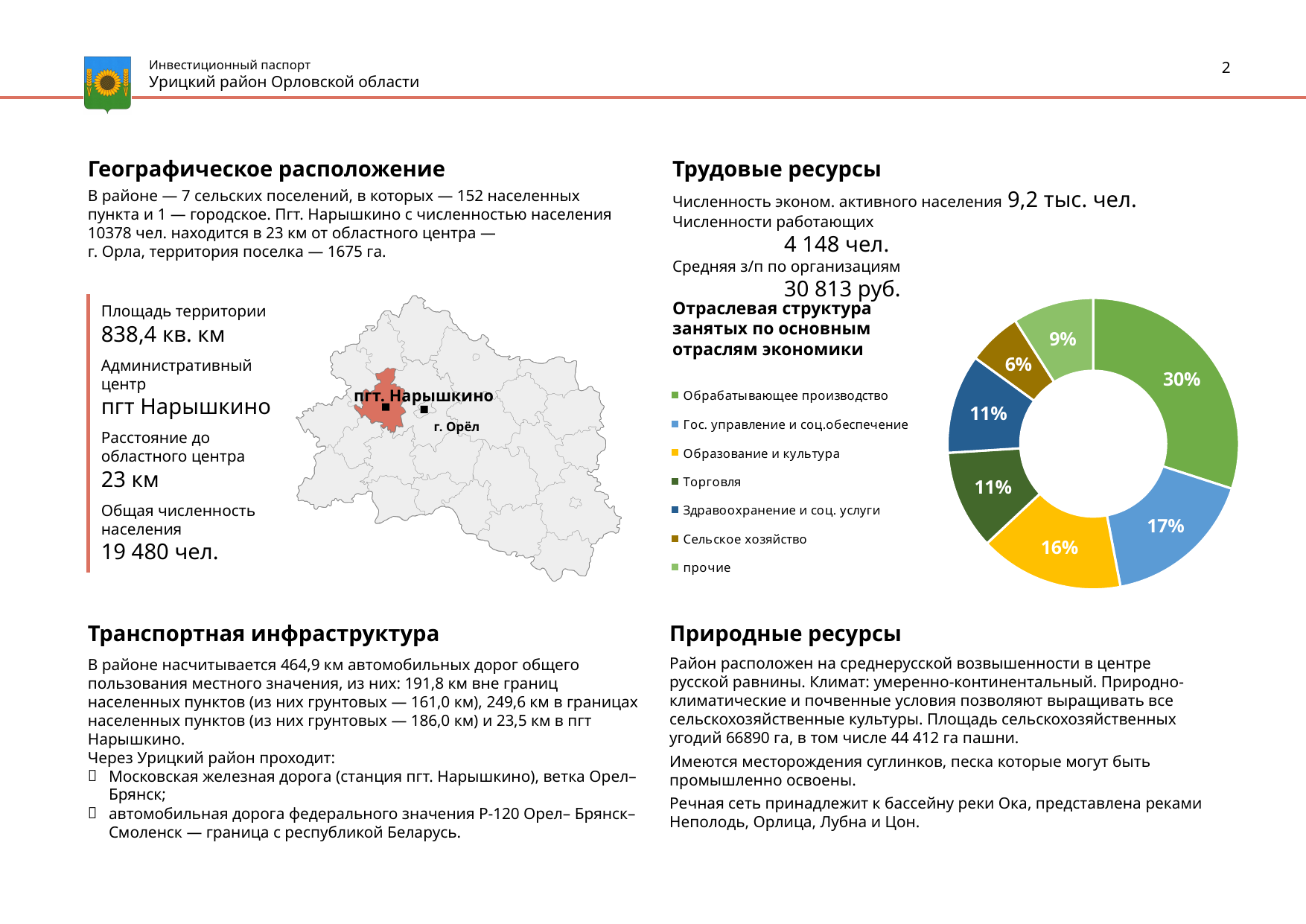
Какая отрасль имеет наименьшую долю занятых на диаграмме? Сельское хозяйство Какова доля обрабатывающего производства в отраслевой структуре занятых? 30% Какой тип диаграммы используется для отраслевой структуры занятых по основным отраслям экономики? Кольцевая (круговая) диаграмма На сколько процентных пунктов доля обрабатывающего производства больше доли гос. управления и соц.обеспечения? 13 Какова доля сельского хозяйства в отраслевой структуре занятых? 6% Что больше: доля образования и культуры или доля торговли? Образование и культура Какова доля образования и культуры в отраслевой структуре занятых? 16% Какая отрасль имеет наибольшую долю занятых на диаграмме? Обрабатывающее производство Сколько отраслей (категорий) перечислено в легенде диаграммы? 7 Какова доля гос. управления и соц.обеспечения в отраслевой структуре занятых? 17% Какова доля категории «прочие» в отраслевой структуре занятых? 9% Каким цветом на диаграмме обозначено образование и культура? Жёлтым